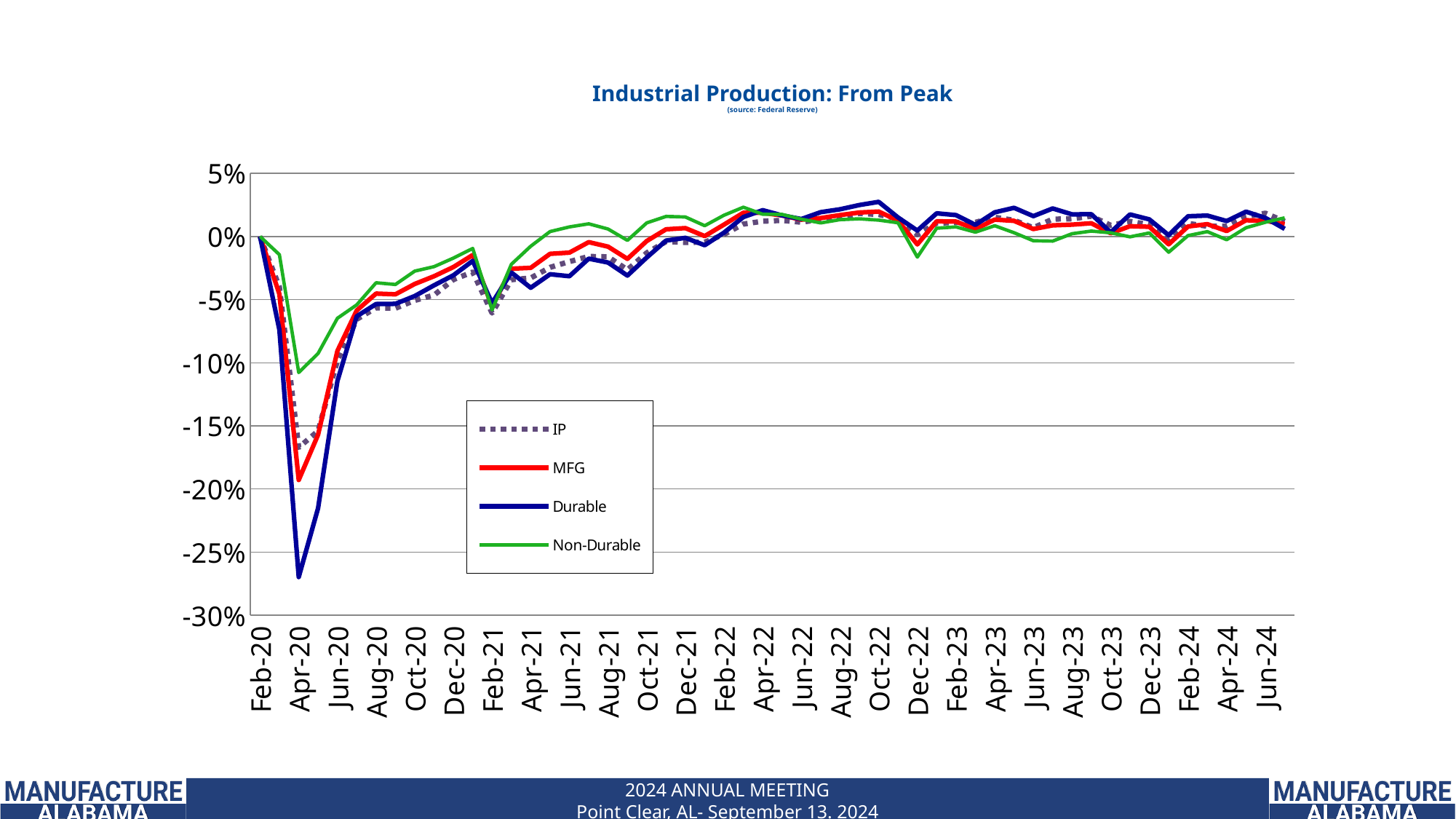
Which series reached the lowest value in Apr-20? Durable How many series does the legend list? 4 Do the values for MFG rise or fall between Apr-20 and Dec-20? rise Is the value for Durable in Oct-22 greater or less than 0%? greater Is the value for Non-Durable in Apr-20 greater or less than -15%? greater In Apr-20, which is larger, the value for Durable or the value for Non-Durable? Non-Durable Is the value for MFG in Apr-20 greater or less than -15%? less What kind of chart is shown on the slide? line chart Which series is drawn as a dotted line in the legend? IP Which series had the smallest decline in Apr-20? Non-Durable What is the title of the chart? Industrial Production: From Peak